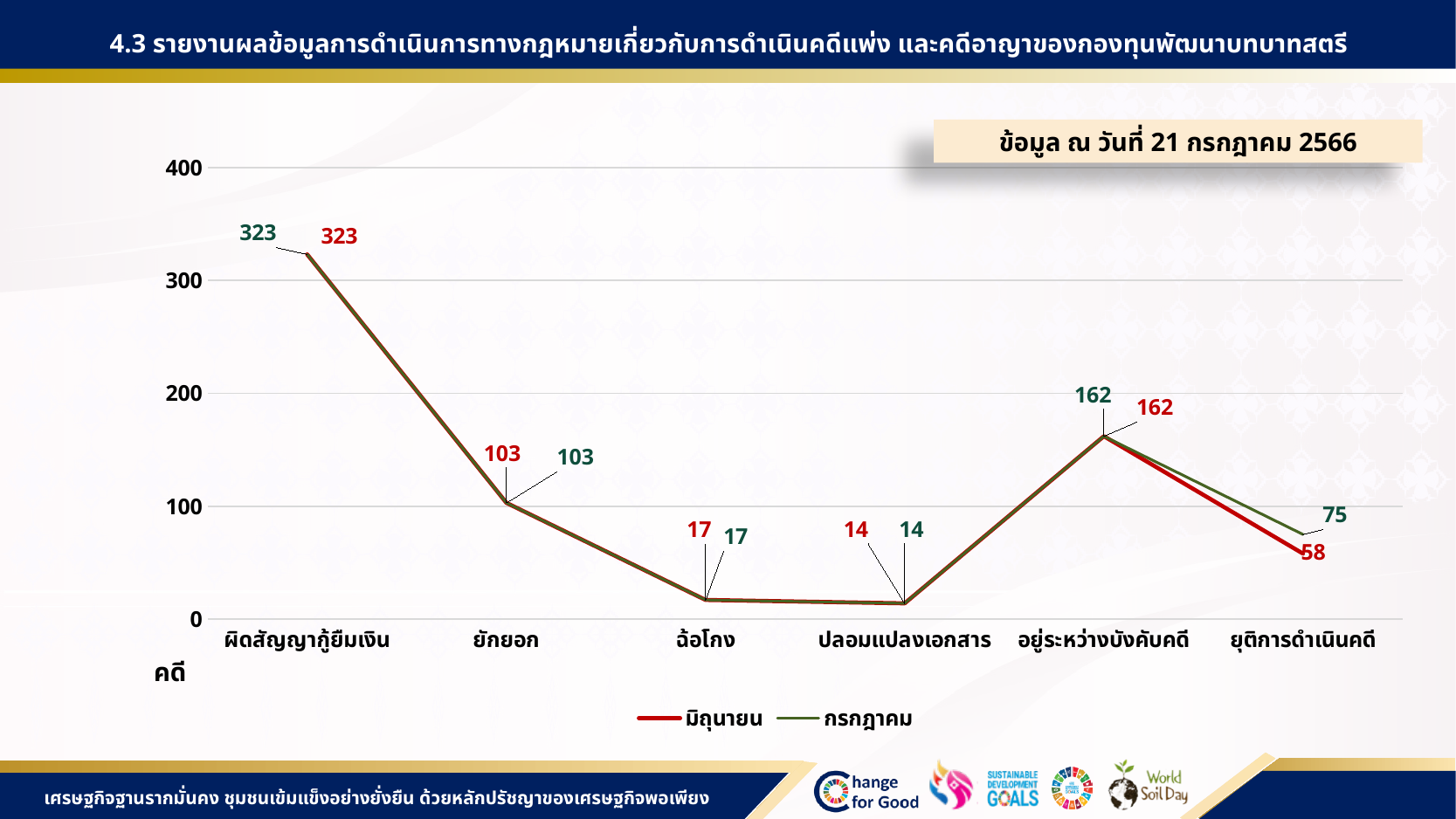
What is the value for ยุติการดำเนินคดี in the มิถุนายน series? 58 What is the value for ยักยอก in the มิถุนายน series? 103 How many categories are shown on the x axis? 6 Which series is drawn in red according to the legend? มิถุนายน Which category has the lowest value in the กรกฎาคม series? ปลอมแปลงเอกสาร For ยุติการดำเนินคดี, which series has the larger value, มิถุนายน or กรกฎาคม? กรกฎาคม How many series does the legend list? 2 What is the value for ผิดสัญญากู้ยืมเงิน in the กรกฎาคม series? 323 Which category has the highest value in the มิถุนายน series? ผิดสัญญากู้ยืมเงิน What is the difference between the กรกฎาคม and มิถุนายน values for ยุติการดำเนินคดี? 17 What kind of chart is shown on the slide? line chart What is the value for ยุติการดำเนินคดี in the กรกฎาคม series? 75